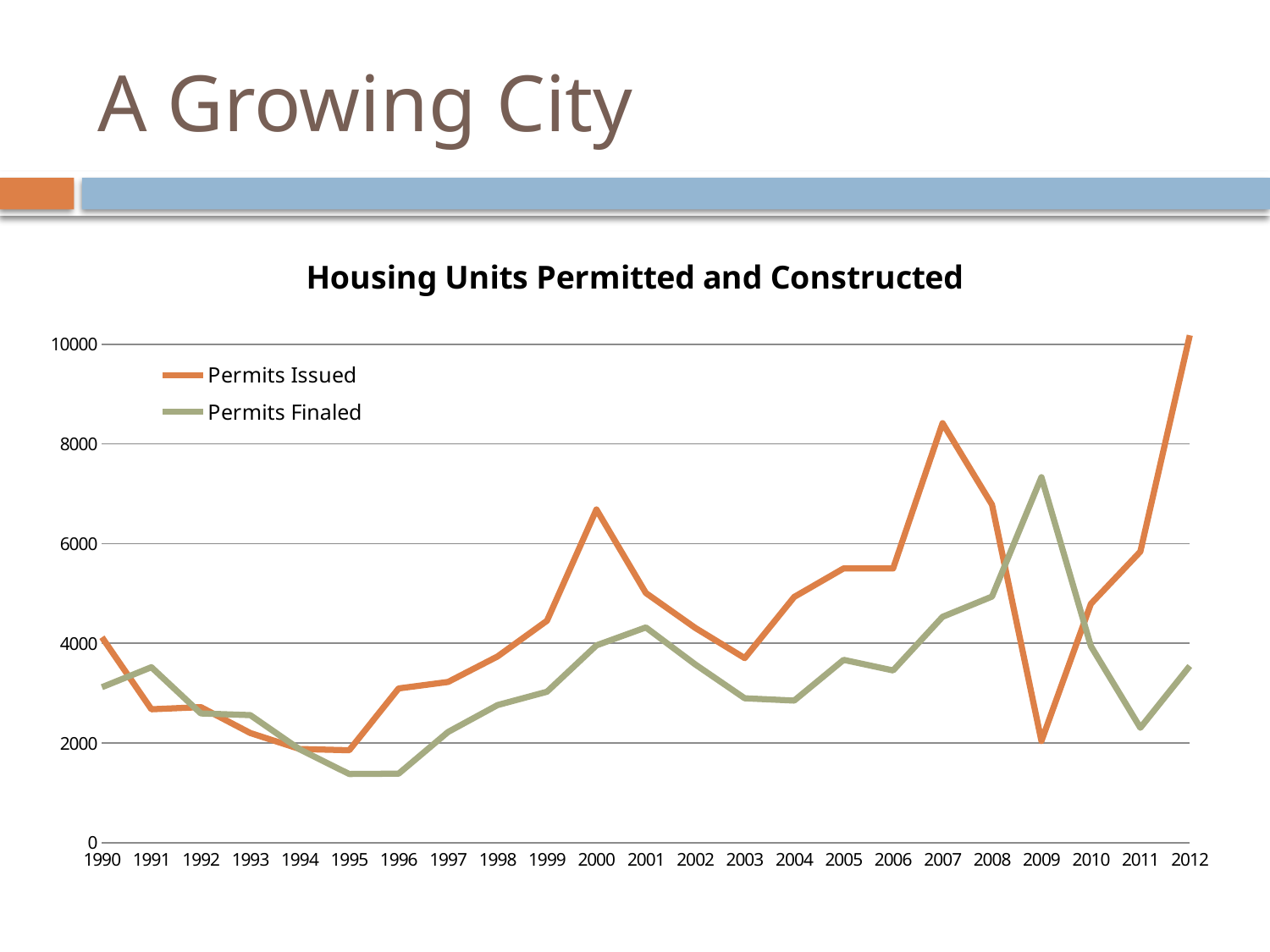
What kind of chart is shown on the slide? line chart Is the Permits Issued value for 2000 greater or less than 6000? greater How many years are plotted along the x axis? 23 Does the Permits Issued line rise or fall from 2009 to 2012? rise Is the Permits Finaled value for 1995 greater or less than 2000? less In 2009, which series has the larger value, Permits Issued or Permits Finaled? Permits Finaled In which year is the Permits Issued value highest? 2012 Is the Permits Issued value for 2007 greater or less than 8000? greater In which year is the Permits Finaled value highest? 2009 What is the title of the chart? Housing Units Permitted and Constructed How many series does the legend list? 2